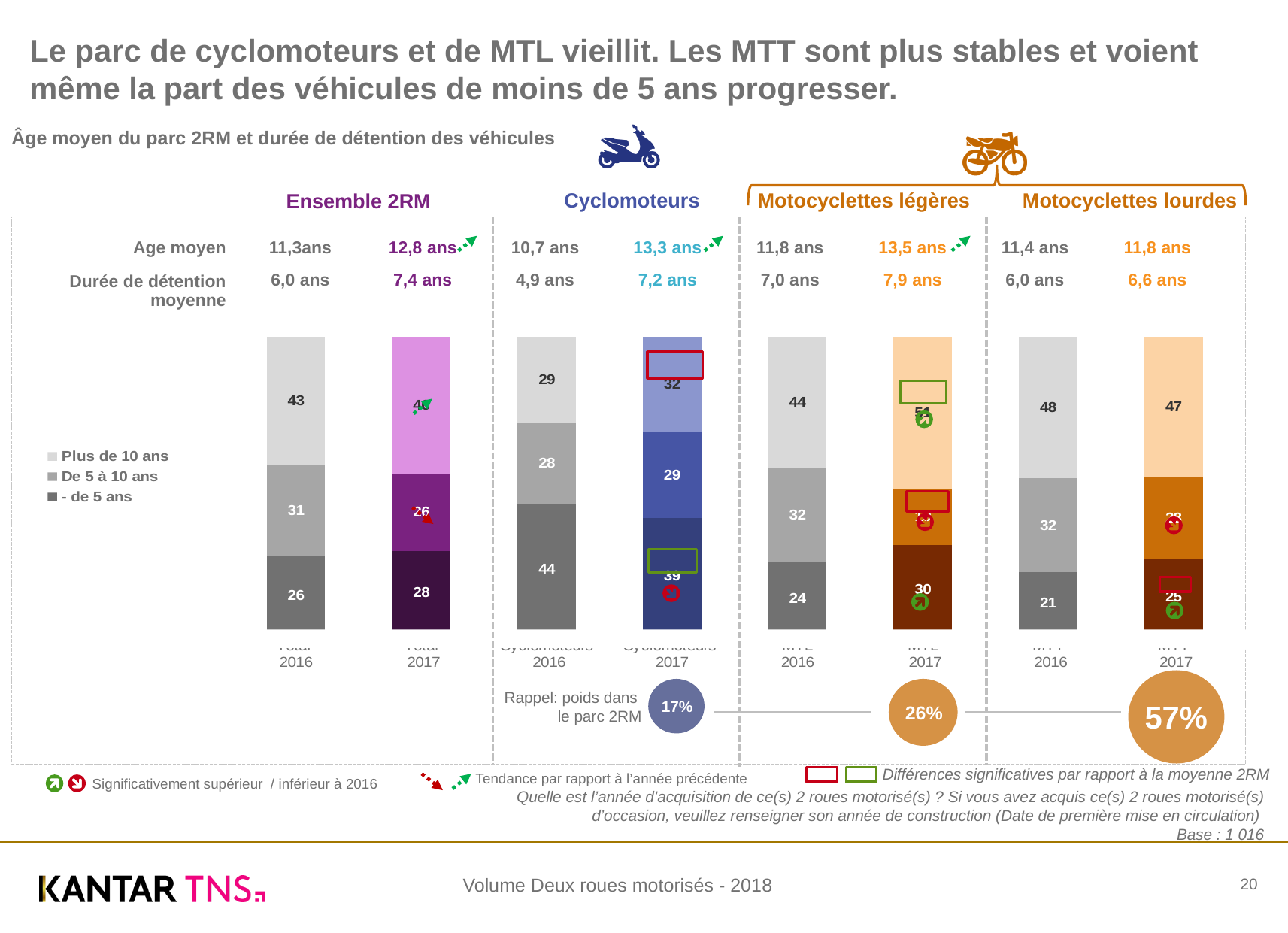
How many bars are plotted in the chart? 8 By how much did the '- de 5 ans' segment for Cyclomoteurs change between 2016 (44) and 2017 (39)? 5 What is the value of the '- de 5 ans' segment for the Cyclomoteurs 2016 bar? 44 What is the total of the three segments in the Total 2016 bar? 100 Among the 2016 bars, which one has the smallest '- de 5 ans' segment? MTT 2016 Among the 2016 bars, which one has the largest '- de 5 ans' segment? Cyclomoteurs 2016 How many series does the legend list? 3 Does the 'Plus de 10 ans' segment for Cyclomoteurs rise or fall from 2016 to 2017? Rise What is the value of the '- de 5 ans' segment for the MTT 2016 bar? 21 Which has a larger 'Plus de 10 ans' segment: MTT 2016 or MTL 2016? MTT 2016 What kind of chart is shown on the slide? Stacked bar chart What is the value of the 'Plus de 10 ans' segment for the MTL 2016 bar? 44